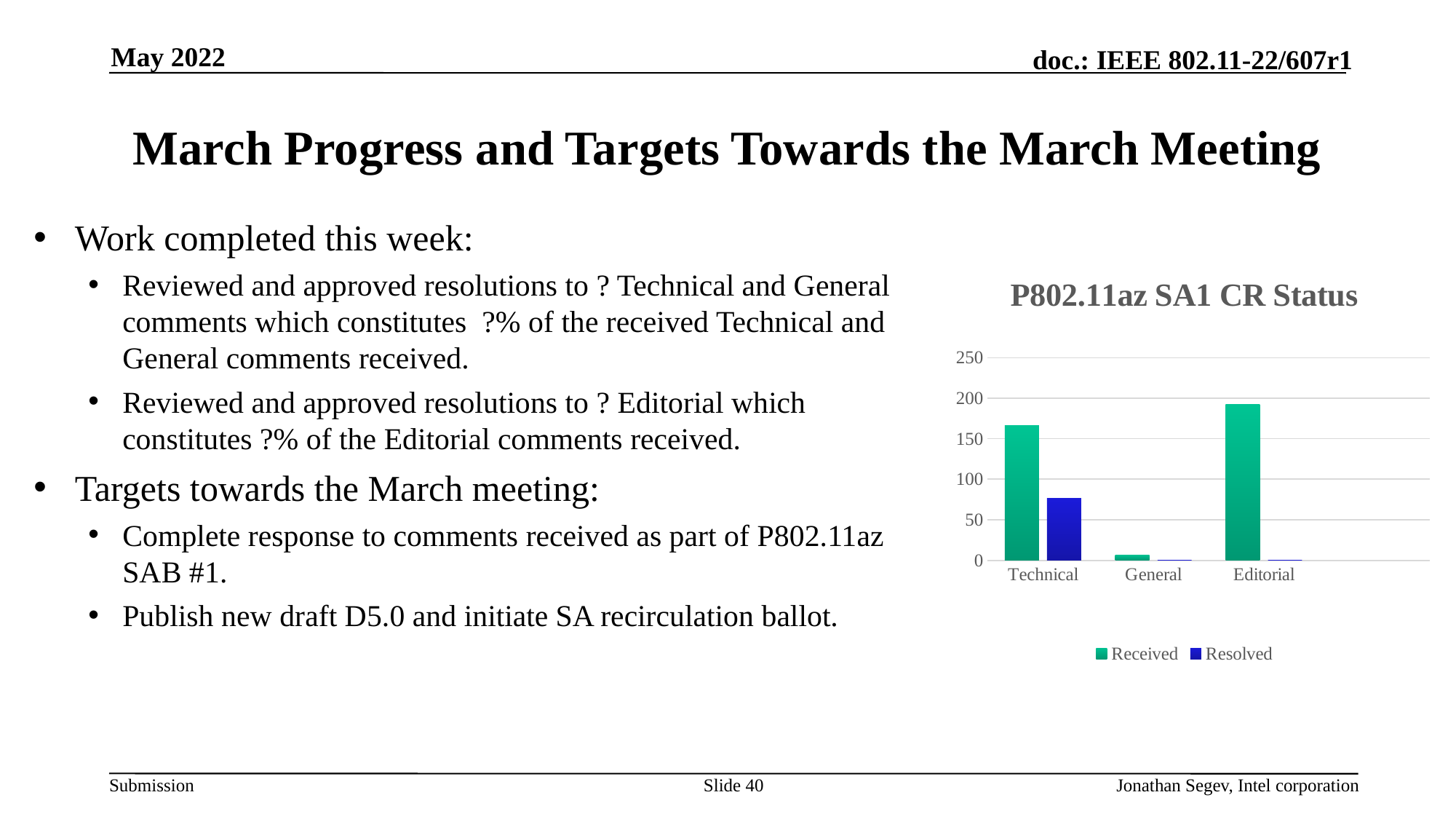
Which category has the lowest Received value? General How many categories are shown on the x axis of the chart? 3 Which category has the highest Resolved value? Technical How many series does the chart legend list? 2 For Technical, which is larger: Received or Resolved? Received Is the Resolved value for Technical greater or less than 50? greater What is the title of the chart? P802.11az SA1 CR Status Which category has the highest Received value? Editorial Which series is shown in blue in the chart legend? Resolved What kind of chart is shown on the slide? bar chart Is the Received value for Technical greater or less than 150? greater Is the Received value for Editorial greater or less than 200? less